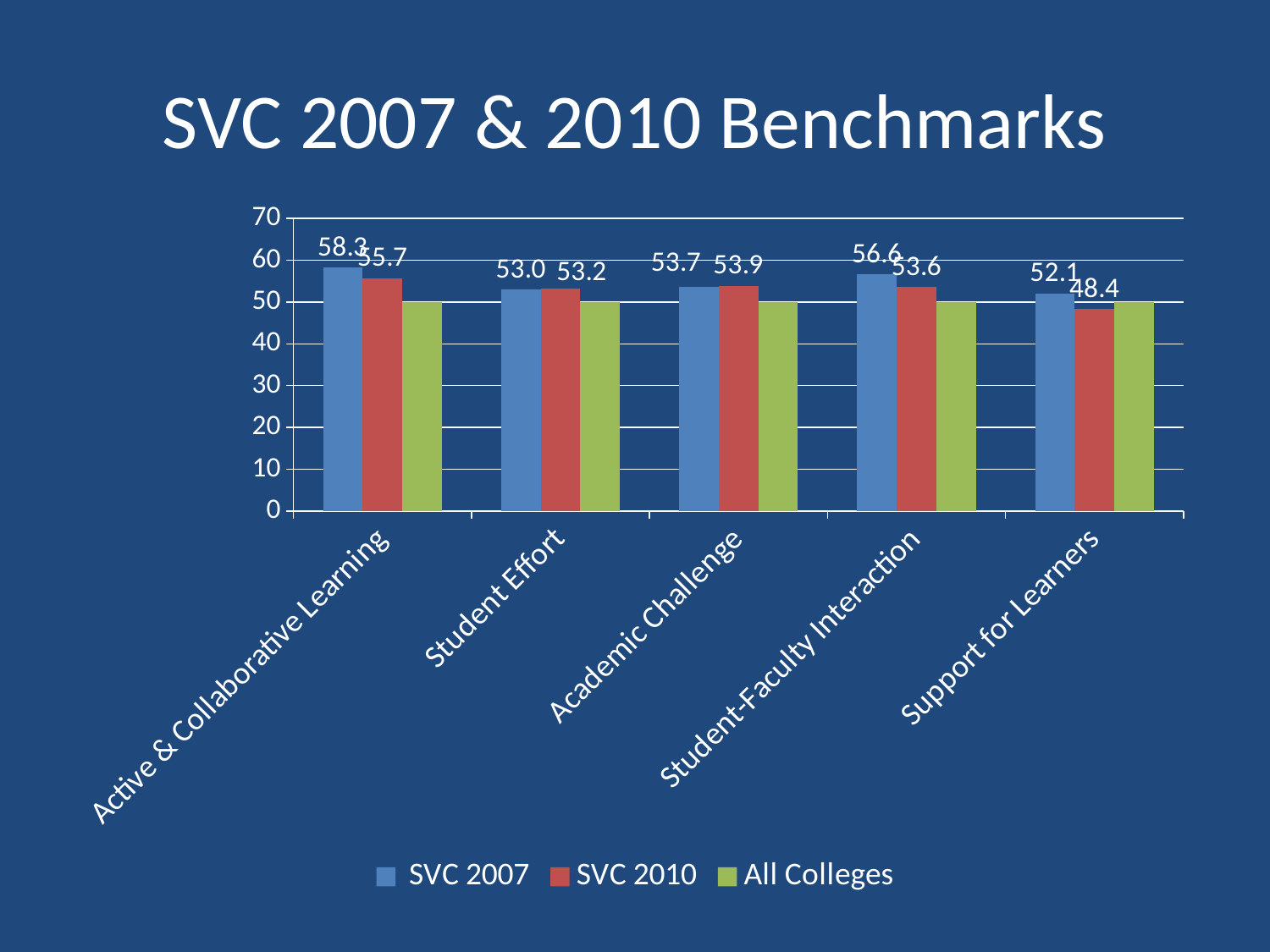
What is the SVC 2010 value for Support for Learners? 48.4 Is the All Colleges value for Student Effort greater or less than 40? greater Which category has the highest SVC 2007 value? Active & Collaborative Learning What is the difference between the SVC 2007 and SVC 2010 values for Support for Learners? 3.7 What is the SVC 2010 value for Student-Faculty Interaction? 53.6 How many benchmark categories are shown on the x axis? 5 What is the SVC 2007 value for Active & Collaborative Learning? 58.3 What is the difference between the SVC 2007 and SVC 2010 values for Student-Faculty Interaction? 3.0 Which is larger for Active & Collaborative Learning, the SVC 2007 value or the SVC 2010 value? SVC 2007 How many series does the legend list? 3 Which category has the lowest SVC 2010 value? Support for Learners What kind of chart is shown on the slide? bar chart